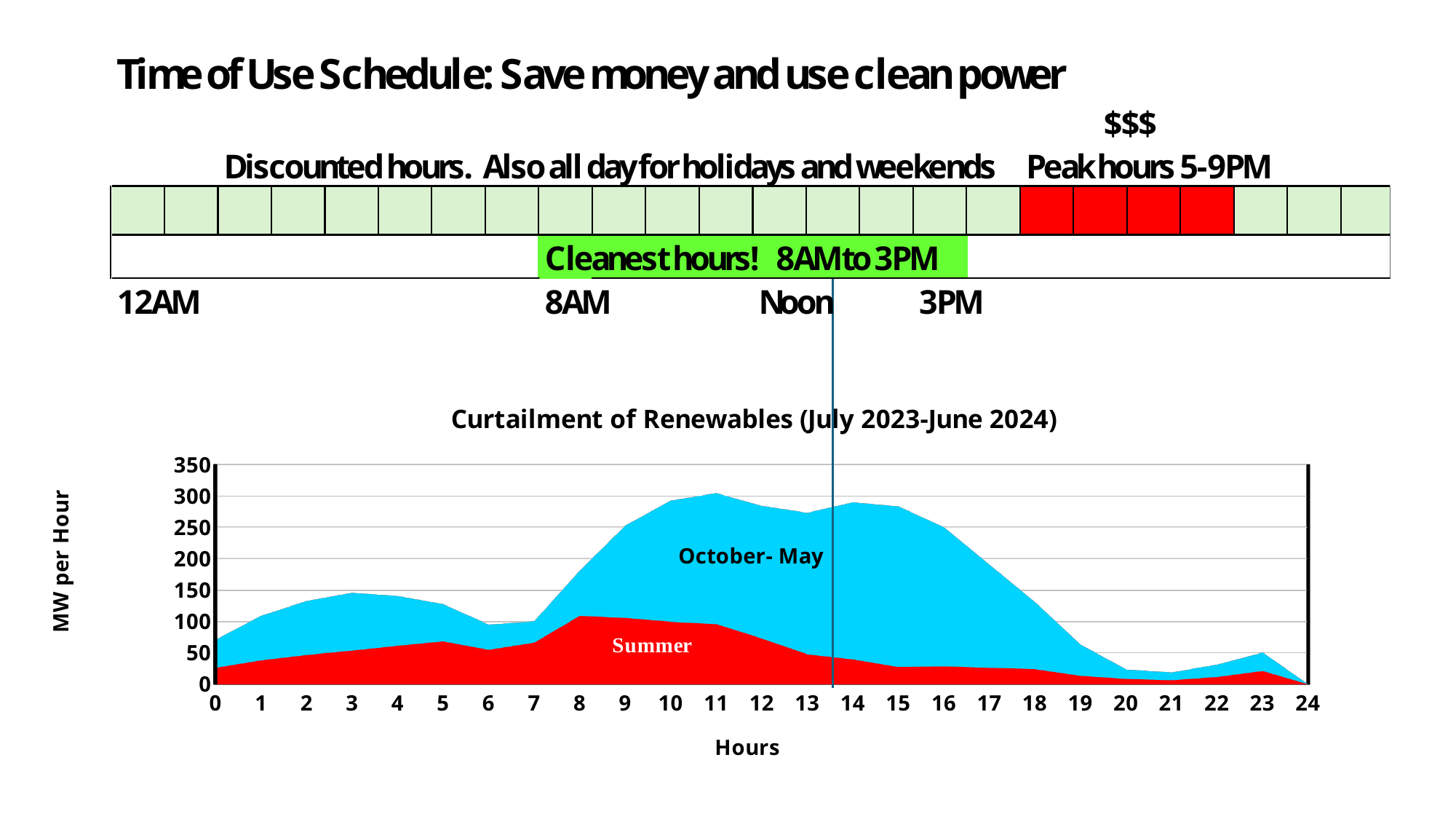
How many hour points are labelled on the x axis of the Curtailment of Renewables chart? 25 What kind of chart is the "Curtailment of Renewables (July 2023-June 2024)" chart? Area chart In the Curtailment of Renewables chart, is the October-May value larger at hour 11 or at hour 3? Hour 11 How many data series are plotted in the Curtailment of Renewables chart? 2 In the Curtailment of Renewables chart, is the Summer value at hour 20 greater or less than 50? less In the Curtailment of Renewables chart, is the Summer value at hour 0 greater or less than 50? less What is the label of the y axis in the Curtailment of Renewables chart? MW per Hour In the Curtailment of Renewables chart, does the October-May series rise or fall between hour 15 and hour 20? Fall What is the title of the chart on the slide? Curtailment of Renewables (July 2023-June 2024) In the Curtailment of Renewables chart, is the Summer value larger at hour 8 or at hour 20? Hour 8